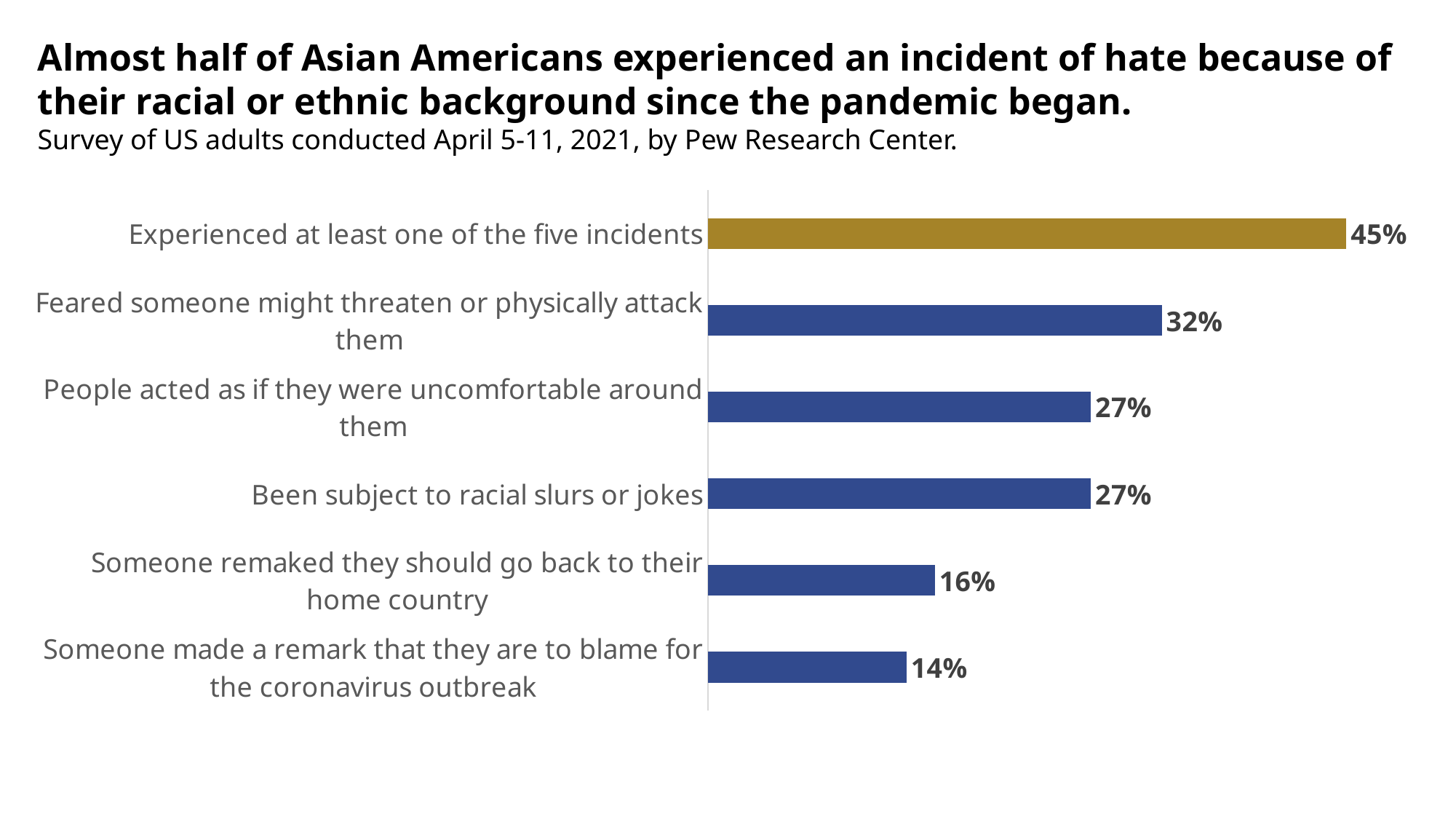
Which is larger: 'Feared someone might threaten or physically attack them' or 'Been subject to racial slurs or jokes'? Feared someone might threaten or physically attack them How many categories are shown in the chart? 6 Which bar is coloured differently (gold) from the others? Experienced at least one of the five incidents What kind of chart is shown on the slide? Bar chart Which category has the lowest value? Someone made a remark that they are to blame for the coronavirus outbreak Which category has the highest value? Experienced at least one of the five incidents What percentage of Asian Americans experienced at least one of the five incidents? 45% What is the difference between 'Someone remaked they should go back to their home country' and 'Someone made a remark that they are to blame for the coronavirus outbreak'? 2% What is the value for 'Feared someone might threaten or physically attack them'? 32% What is the value for 'Someone made a remark that they are to blame for the coronavirus outbreak'? 14% What is the value for 'Been subject to racial slurs or jokes'? 27% What is the difference between 'Experienced at least one of the five incidents' and 'Feared someone might threaten or physically attack them'? 13%